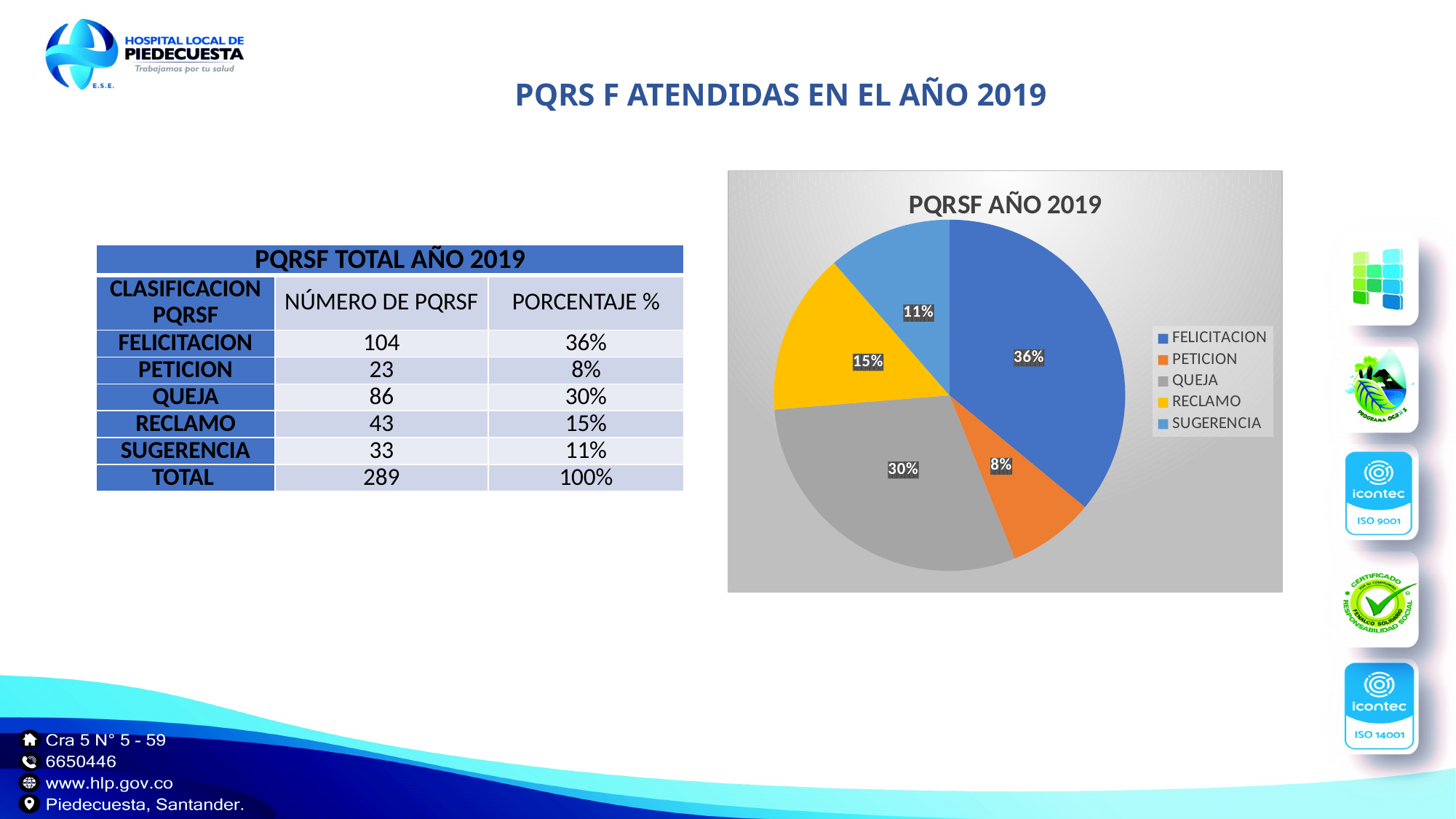
What share of the pie does SUGERENCIA represent? 11% What share of the pie does FELICITACION represent? 36% Which category has the smallest slice of the pie? PETICION What share of the pie does RECLAMO represent? 15% What kind of chart is shown on the slide? pie chart What is the title of the chart? PQRSF AÑO 2019 What is the difference in percentage points between the FELICITACION slice and the QUEJA slice? 6% Which category has the largest slice of the pie? FELICITACION How many categories does the pie chart show? 5 Which is larger, the slice for RECLAMO or the slice for SUGERENCIA? RECLAMO